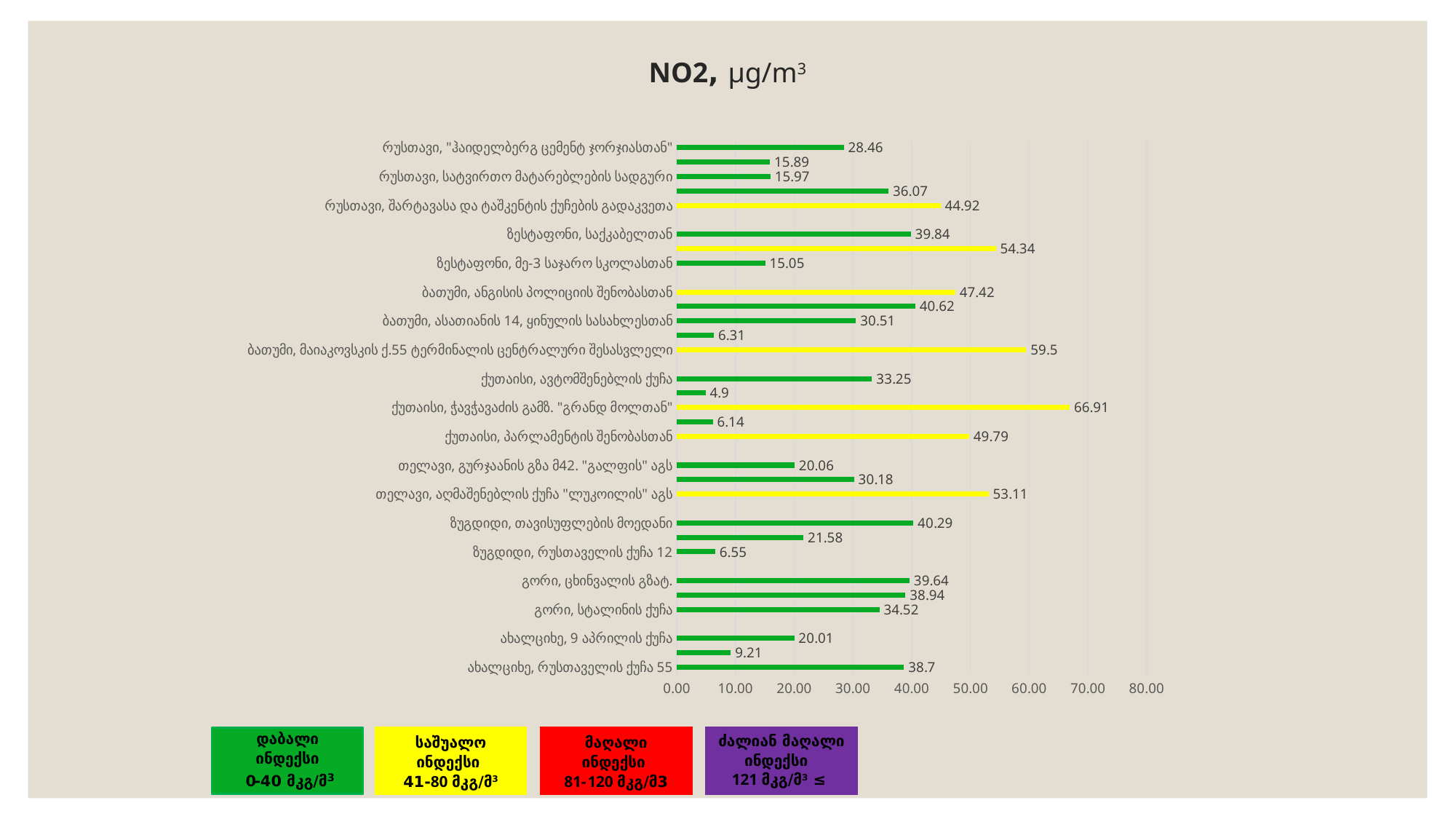
Is the NO2 value for თელავი, აღმაშენებლის ქუჩა "ლუკოილის" აგს greater or less than 50.00? greater What is the NO2 value for ახალციხე, რუსთაველის ქუჩა 55? 38.7 Which labelled location has the highest NO2 value? ქუთაისი, ჭავჭავაძის გამზ. "გრანდ მოლთან" What is the difference between the NO2 values for ქუთაისი, ჭავჭავაძის გამზ. "გრანდ მოლთან" and ბათუმი, მაიაკოვსკის ქ.55 ტერმინალის ცენტრალური შესასვლელი? 7.41 What is the NO2 value for ქუთაისი, ჭავჭავაძის გამზ. "გრანდ მოლთან"? 66.91 What is the title of the chart? NO2, μg/m³ What is the NO2 value for ზუგდიდი, რუსთაველის ქუჩა 12? 6.55 What is the NO2 value for ბათუმი, მაიაკოვსკის ქ.55 ტერმინალის ცენტრალური შესასვლელი? 59.5 What type of chart is shown on the slide? bar chart What is the smallest NO2 value printed on the chart? 4.9 Which has a higher NO2 value: ზესტაფონი, საქკაბელთან or ზესტაფონი, მე-3 საჯარო სკოლასთან? ზესტაფონი, საქკაბელთან How many bars on the chart are coloured yellow? 7